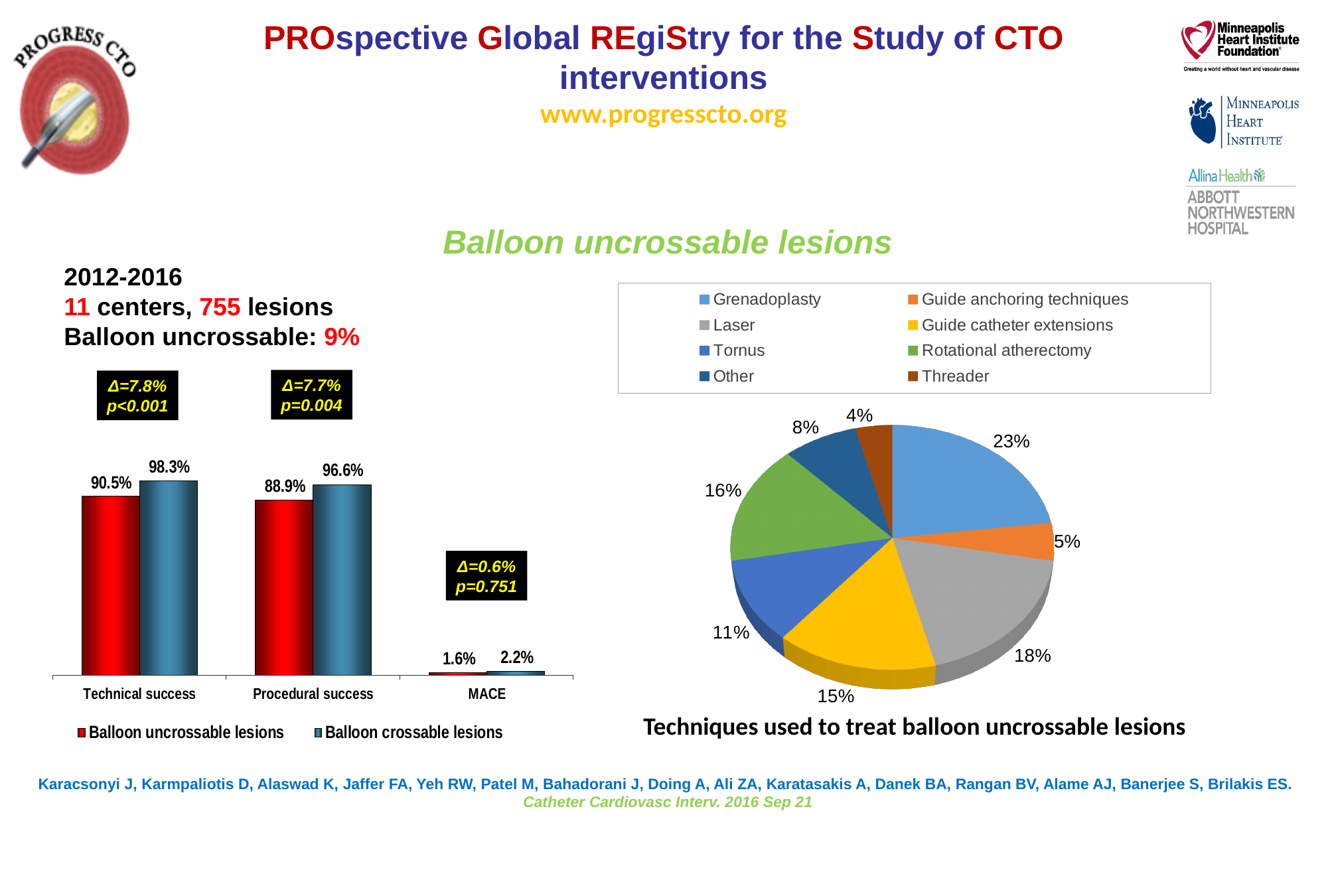
In the bar chart on the left, what is the MACE rate for balloon uncrossable lesions? 1.6% In the bar chart on the left, what is the procedural success rate for balloon crossable lesions? 96.6% In the pie chart 'Techniques used to treat balloon uncrossable lesions', what share is Laser? 18% In the pie chart 'Techniques used to treat balloon uncrossable lesions', which technique has the smallest share? Threader In the bar chart on the left, how many series does the legend list? 2 In the bar chart on the left, which category has the lowest values for both series? MACE In the pie chart 'Techniques used to treat balloon uncrossable lesions', how many techniques are shown? 8 What type of chart is shown on the right side of the slide? Pie chart In the bar chart on the left, what is the technical success rate for balloon uncrossable lesions? 90.5% In the bar chart on the left, is the procedural success rate higher for balloon uncrossable lesions or balloon crossable lesions? Balloon crossable lesions In the bar chart on the left, what is the difference between technical success for balloon crossable lesions and balloon uncrossable lesions? 7.8% In the pie chart 'Techniques used to treat balloon uncrossable lesions', what share is Grenadoplasty? 23%